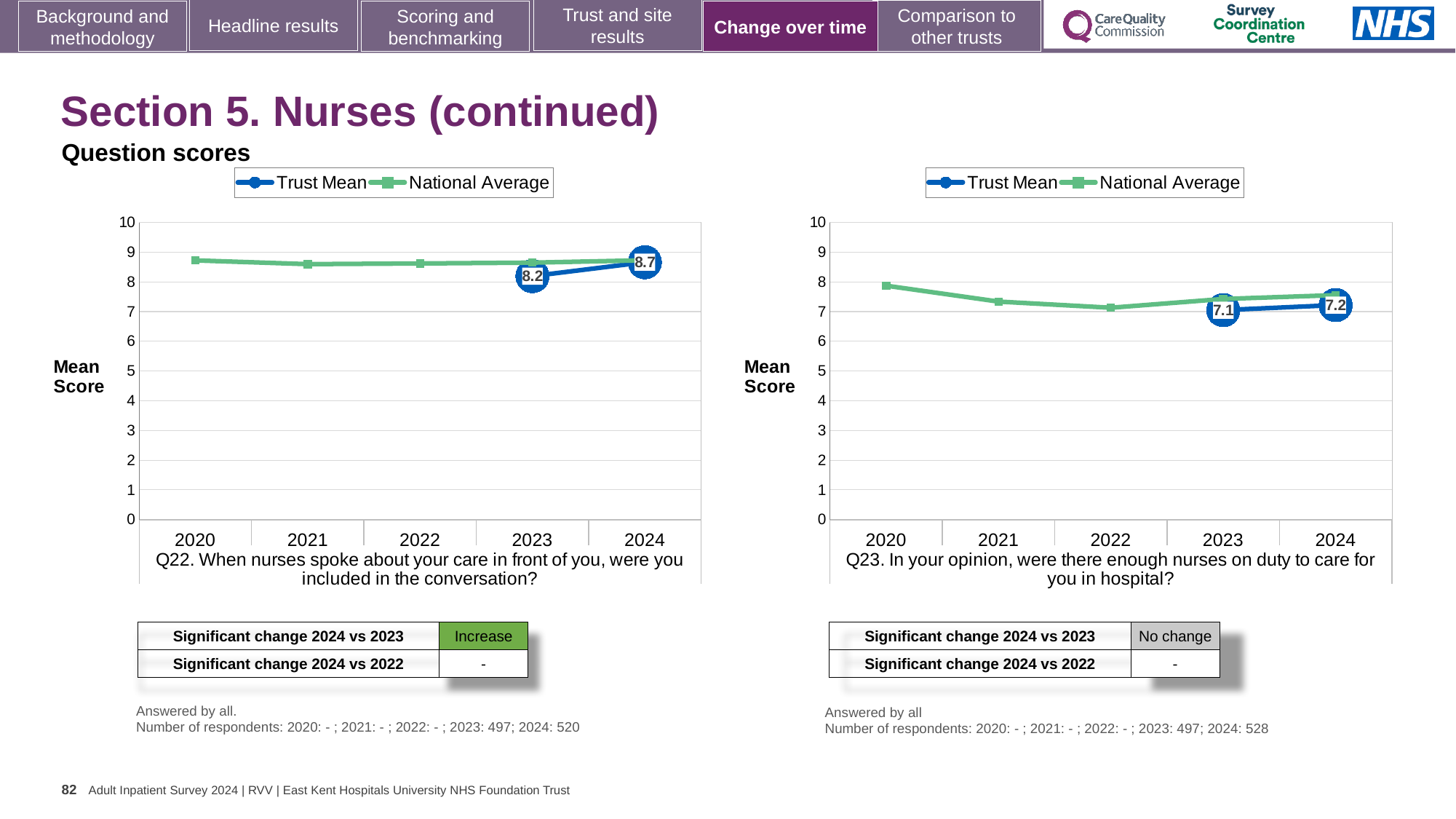
On the right chart (Q23), what is the Trust Mean score for 2024? 7.2 On the right chart (Q23), what is the difference between the Trust Mean for 2024 and 2023? 0.1 On the left chart (Q22), by how much did the Trust Mean change from 2023 to 2024? 0.5 What kind of chart is the left chart (Q22)? line chart How many series does the legend of the right chart (Q23) list? 2 On the left chart (Q22), is the National Average for 2021 greater or less than 8? greater On the right chart (Q23), what is the Trust Mean score for 2023? 7.1 On the left chart (Q22), is the Trust Mean higher in 2023 or 2024? 2024 On the right chart (Q23), is the National Average for 2022 greater or less than 8? less On the left chart (Q22), what is the Trust Mean score for 2024? 8.7 On the left chart (Q22), does the Trust Mean rise or fall from 2023 to 2024? rise On the left chart (Q22), what is the Trust Mean score for 2023? 8.2